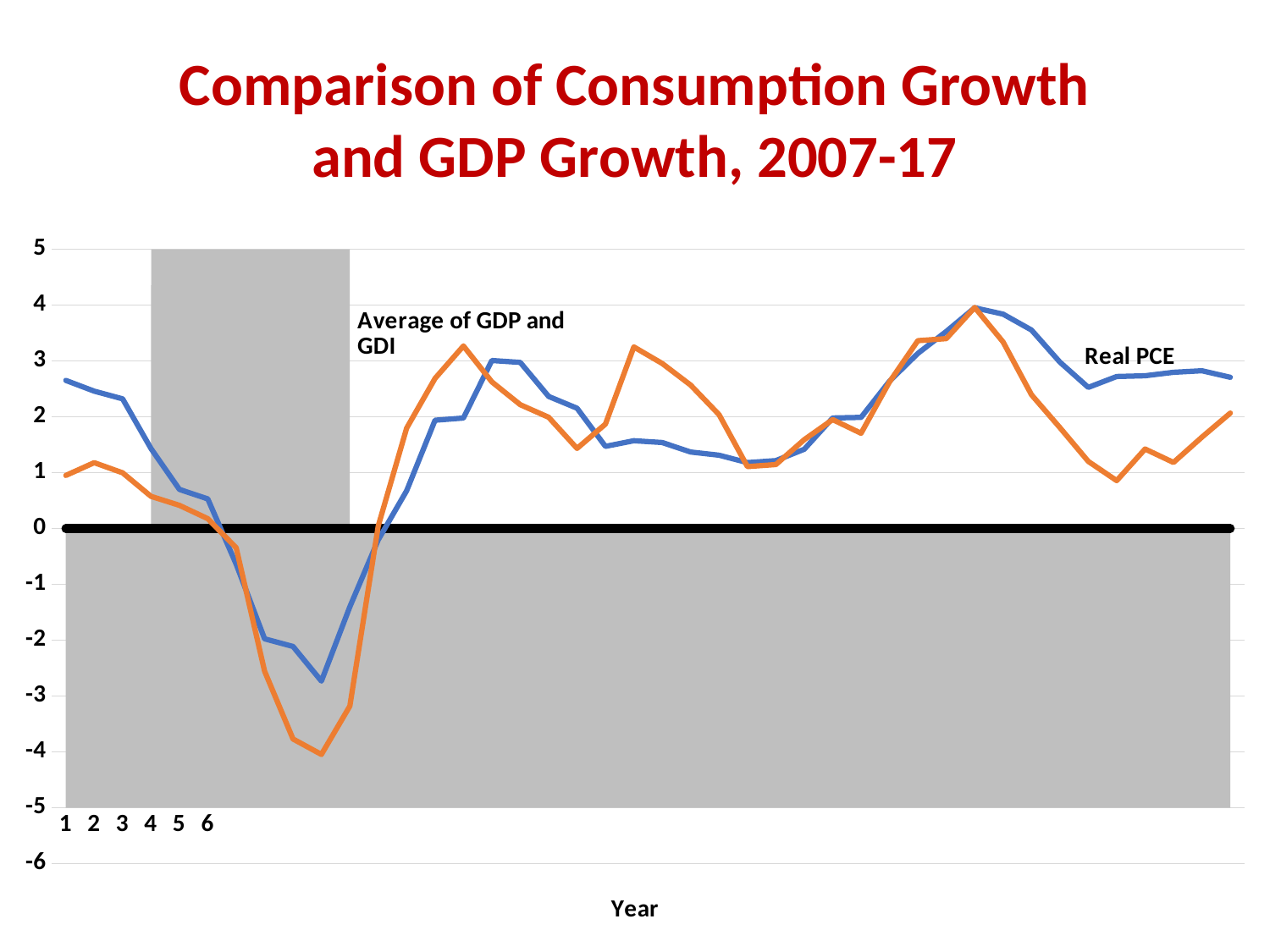
Is the lowest value of the Real PCE line greater or less than -2? less Is the highest value of the Real PCE line greater or less than 3? greater At year 1, is the value of Real PCE greater or less than 2? greater Which series reaches the lowest value on the chart, Real PCE or Average of GDP and GDI? Average of GDP and GDI How many data series are plotted on the chart? 2 At year 1, which series has the larger value, Real PCE or Average of GDP and GDI? Real PCE What is the title of the chart on the slide? Comparison of Consumption Growth and GDP Growth, 2007-17 Does the Real PCE line rise or fall from year 1 to year 6? fall What colour is the Real PCE line? blue What kind of chart is shown on the slide? line chart